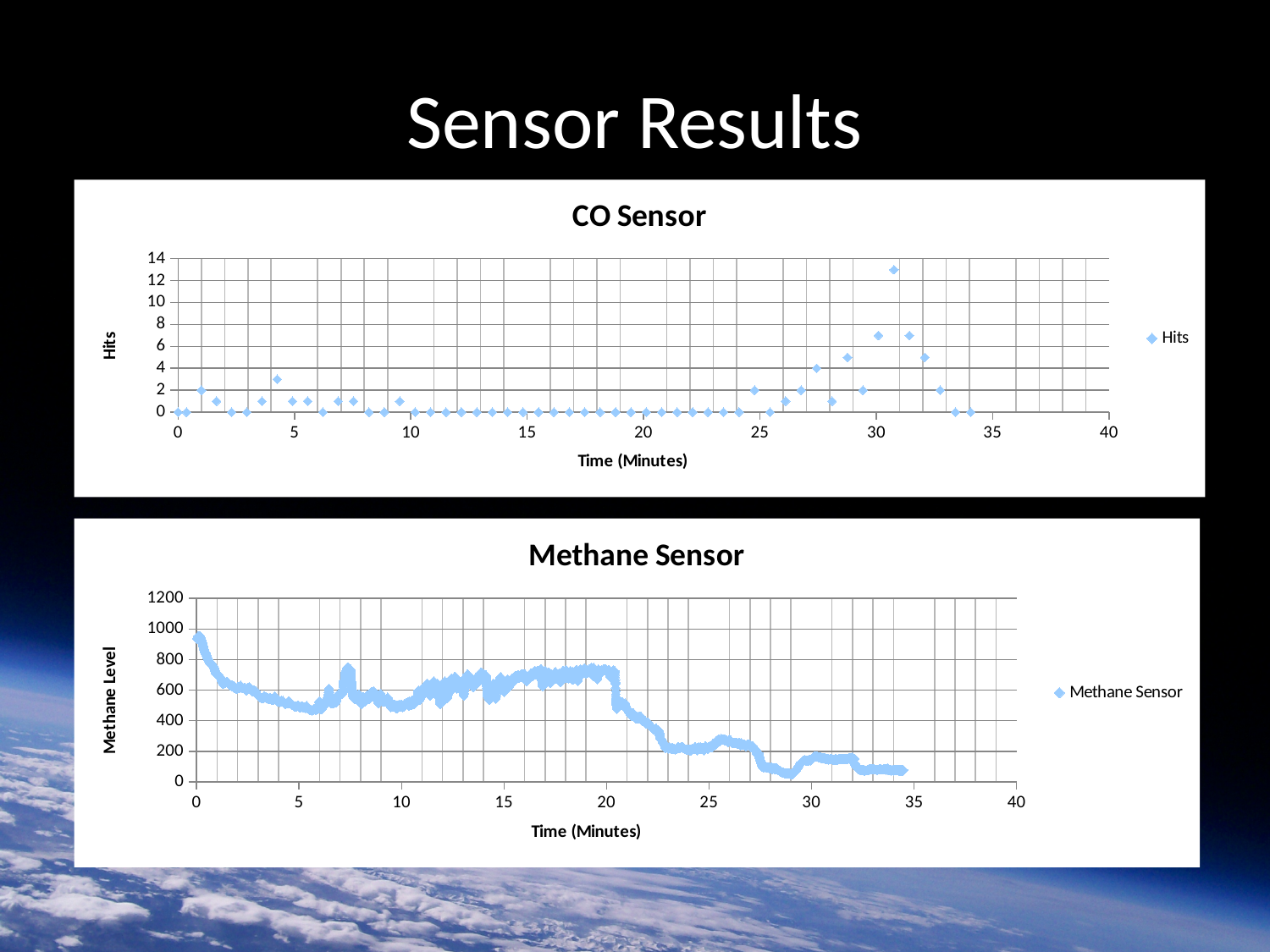
In the CO Sensor chart, what is the name of the series shown in the legend? Hits What kind of chart is the Methane Sensor chart? scatter chart In the CO Sensor chart, is the value of Hits at 20 minutes greater or less than 2? less What kind of chart is the CO Sensor chart? scatter chart In the CO Sensor chart, does the highest value of Hits occur before or after 30 minutes? after What is the y-axis title of the Methane Sensor chart? Methane Level How many series does the legend of the Methane Sensor chart list? 1 In the Methane Sensor chart, is the methane level at 30 minutes greater or less than 400? less How many series does the legend of the CO Sensor chart list? 1 In the Methane Sensor chart, is the methane level at 0 minutes greater or less than 800? greater In the Methane Sensor chart, is the methane level higher at 5 minutes or at 25 minutes? 5 minutes